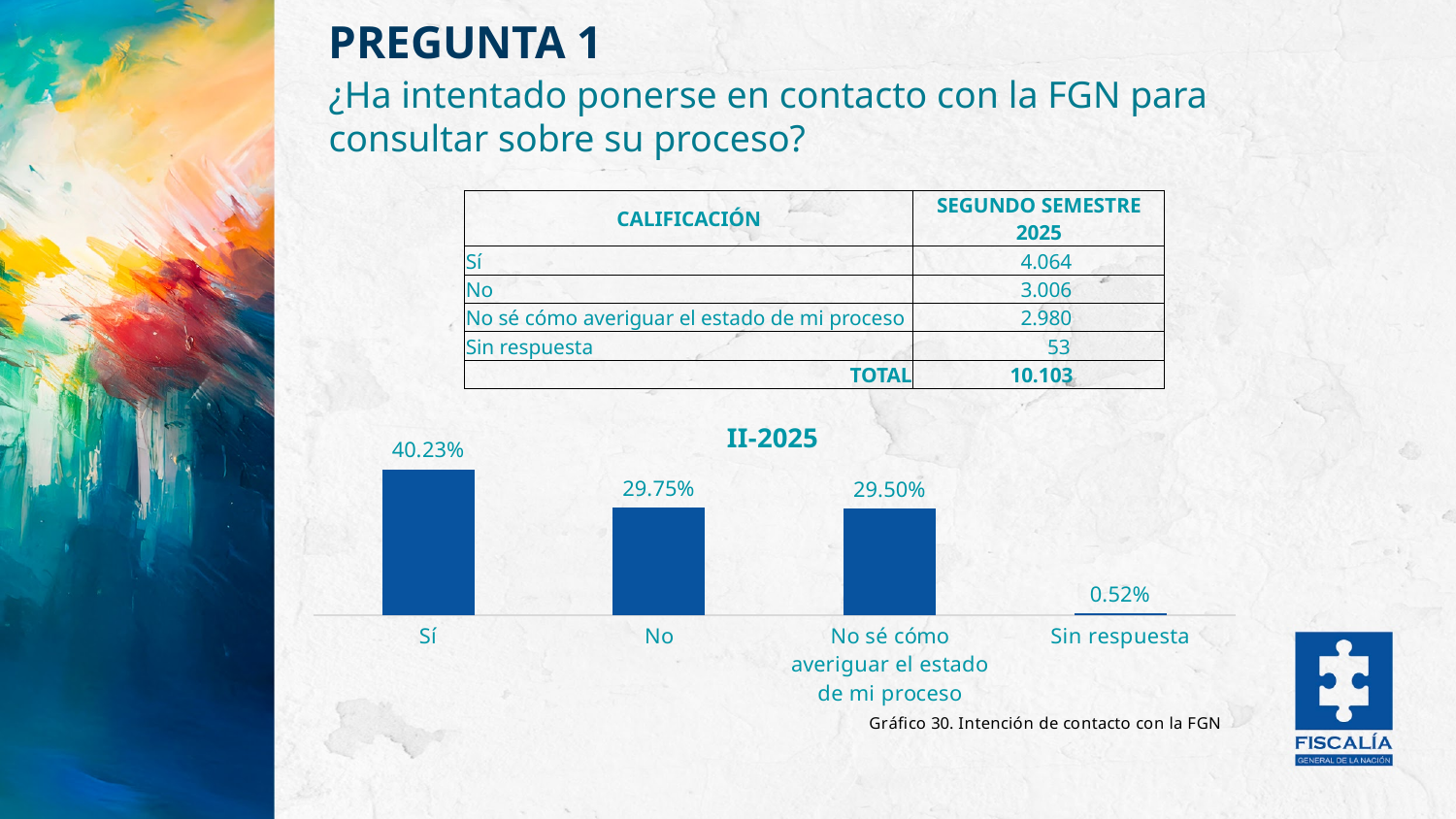
What kind of chart is the II-2025 chart? Bar chart Which category has the lowest value in the II-2025 chart? Sin respuesta Which category has the highest value in the II-2025 chart? Sí How many categories are shown in the II-2025 chart? 4 What is the title of the bar chart on the slide? II-2025 What is the value for Sin respuesta in the II-2025 chart? 0.52% What is the value for Sí in the II-2025 chart? 40.23% What is the value for 'No sé cómo averiguar el estado de mi proceso' in the II-2025 chart? 29.50% What is the difference between the values for Sí and No in the II-2025 chart? 10.48 percentage points In the II-2025 chart, which is larger: the value for Sí or the value for No? Sí What is the value for No in the II-2025 chart? 29.75% What is the difference between the values for No and 'No sé cómo averiguar el estado de mi proceso' in the II-2025 chart? 0.25 percentage points